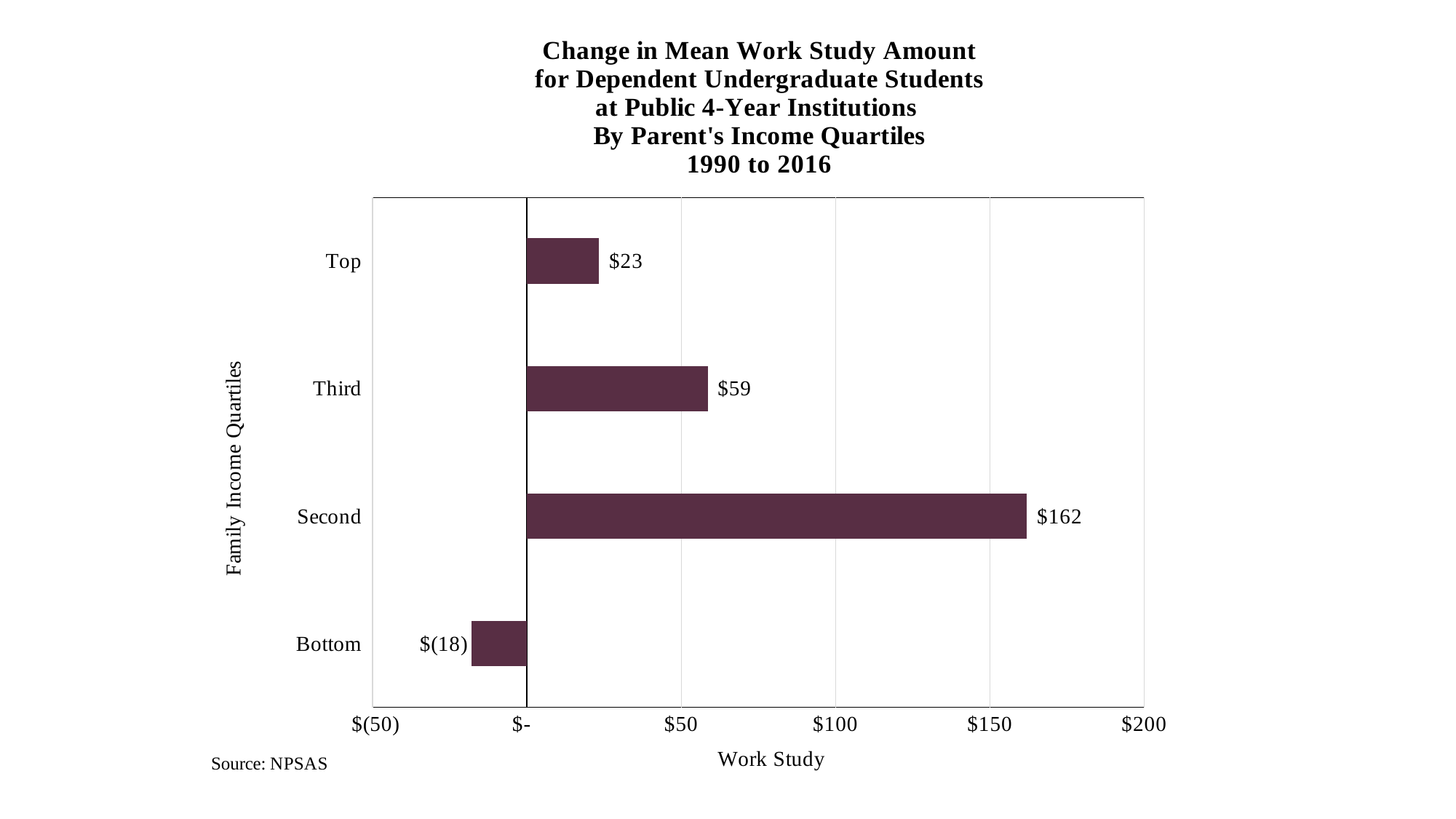
How many family income quartiles are shown on the chart? 4 Which is larger, the value for the Third quartile or the Top quartile? Third Is the value for the Second quartile greater or less than $150? greater Which family income quartile has the highest change in mean work study amount? Second What is the change in mean work study amount for the Third quartile? $59 What is the difference between the Second and Third quartile values? $103 What is the change in mean work study amount for the Second quartile? $162 What is the source cited for the chart? NPSAS What is the change in mean work study amount for the Top quartile? $23 Which family income quartile has the lowest change in mean work study amount? Bottom What kind of chart is shown on the slide? Bar chart What is the change in mean work study amount for the Bottom quartile? $(18)